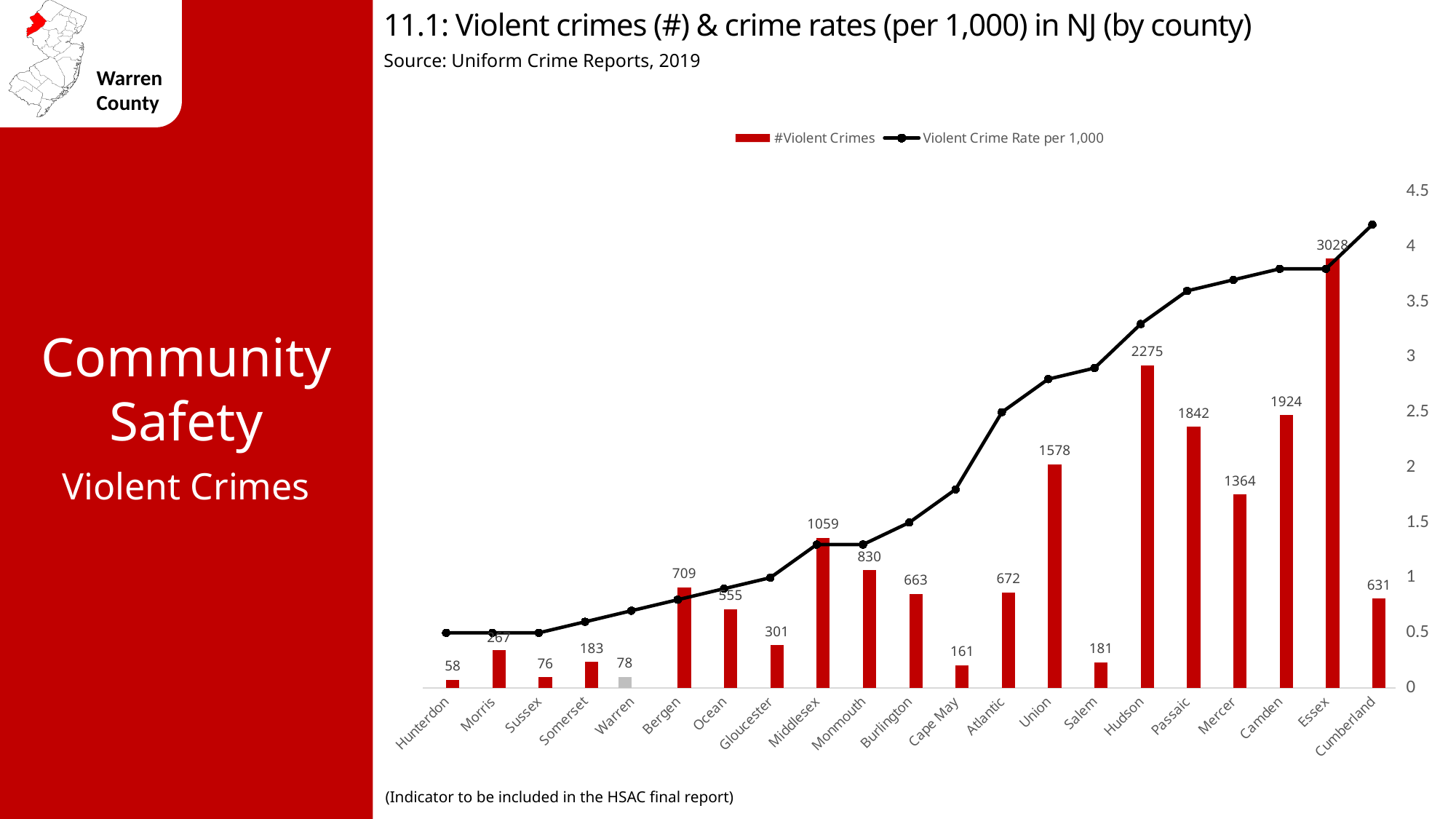
What is the number of violent crimes for Warren? 78 Which county has the highest number of violent crimes? Essex How many series does the legend list? 2 Which county has more violent crimes, Camden or Passaic? Camden Which county has the lowest number of violent crimes? Hunterdon How many counties are shown on the x axis? 21 Does the violent crime rate per 1,000 line generally rise or fall from Hunterdon to Cumberland? rise What is the difference in the number of violent crimes between Hudson and Passaic? 433 How many violent crimes are shown for Essex? 3028 Is the violent crime rate per 1,000 for Cumberland greater or less than 4? greater What kind of chart is this? Combined bar and line chart Is the violent crime rate per 1,000 for Middlesex greater or less than 1.5? less